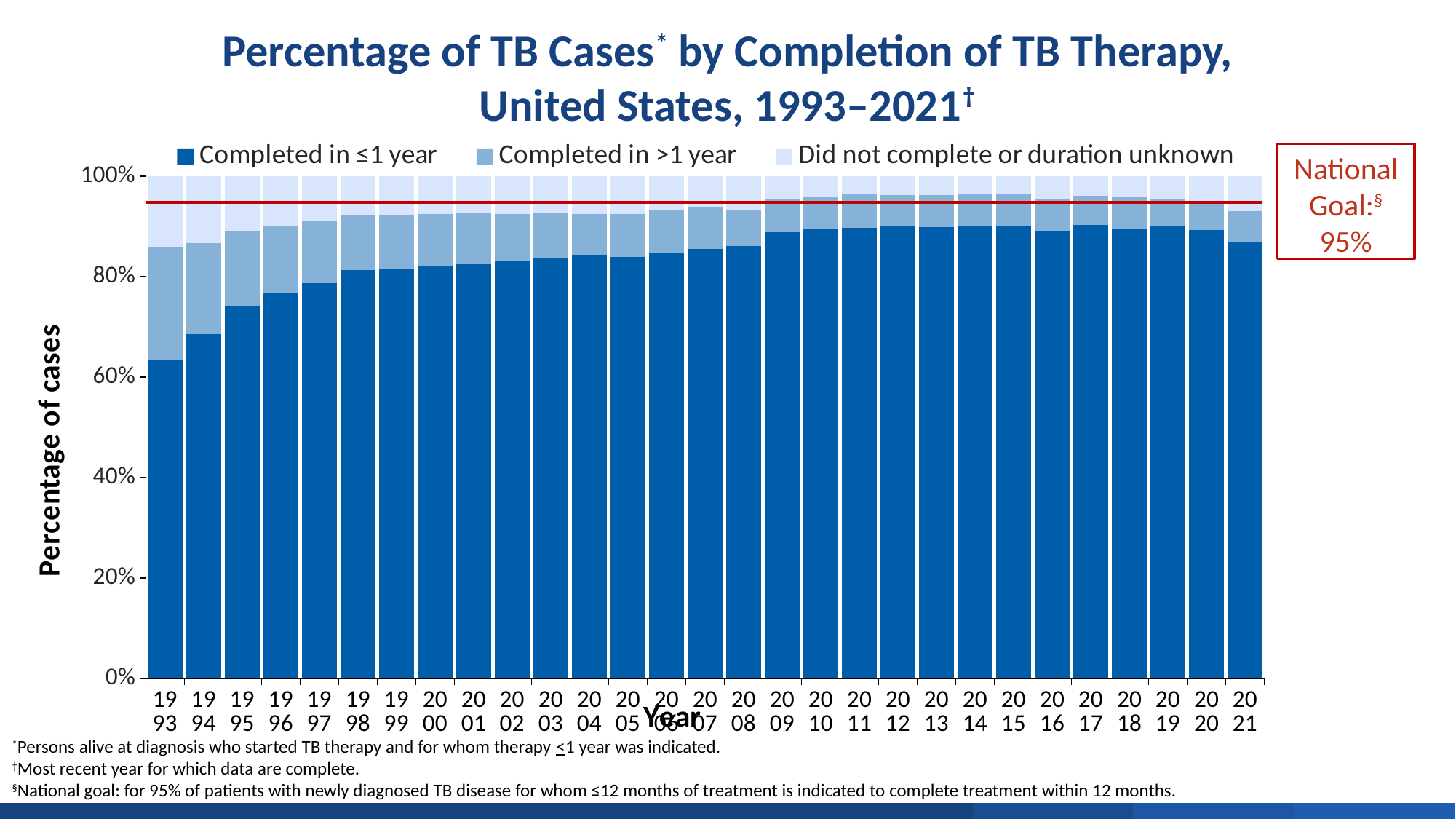
Is the 'Completed in ≤1 year' value for 1993 greater or less than 80%? less What kind of chart is shown on the slide? Stacked bar chart How many years are plotted along the x axis? 29 Which year has the lowest 'Completed in ≤1 year' percentage? 1993 What percentage is the National Goal marked by the red line? 95% Is the 'Completed in ≤1 year' value for 2021 greater or less than 80%? greater Does the 'Completed in ≤1 year' share generally rise or fall from 1993 to 2021? Rise Which year has the larger 'Did not complete or duration unknown' share, 1993 or 2015? 1993 How many series does the legend list? 3 Is the 'Completed in ≤1 year' value for 1993 greater or less than 60%? greater What do the three segments of each stacked bar add up to? 100% Which year has the larger 'Completed in ≤1 year' percentage, 1993 or 2021? 2021